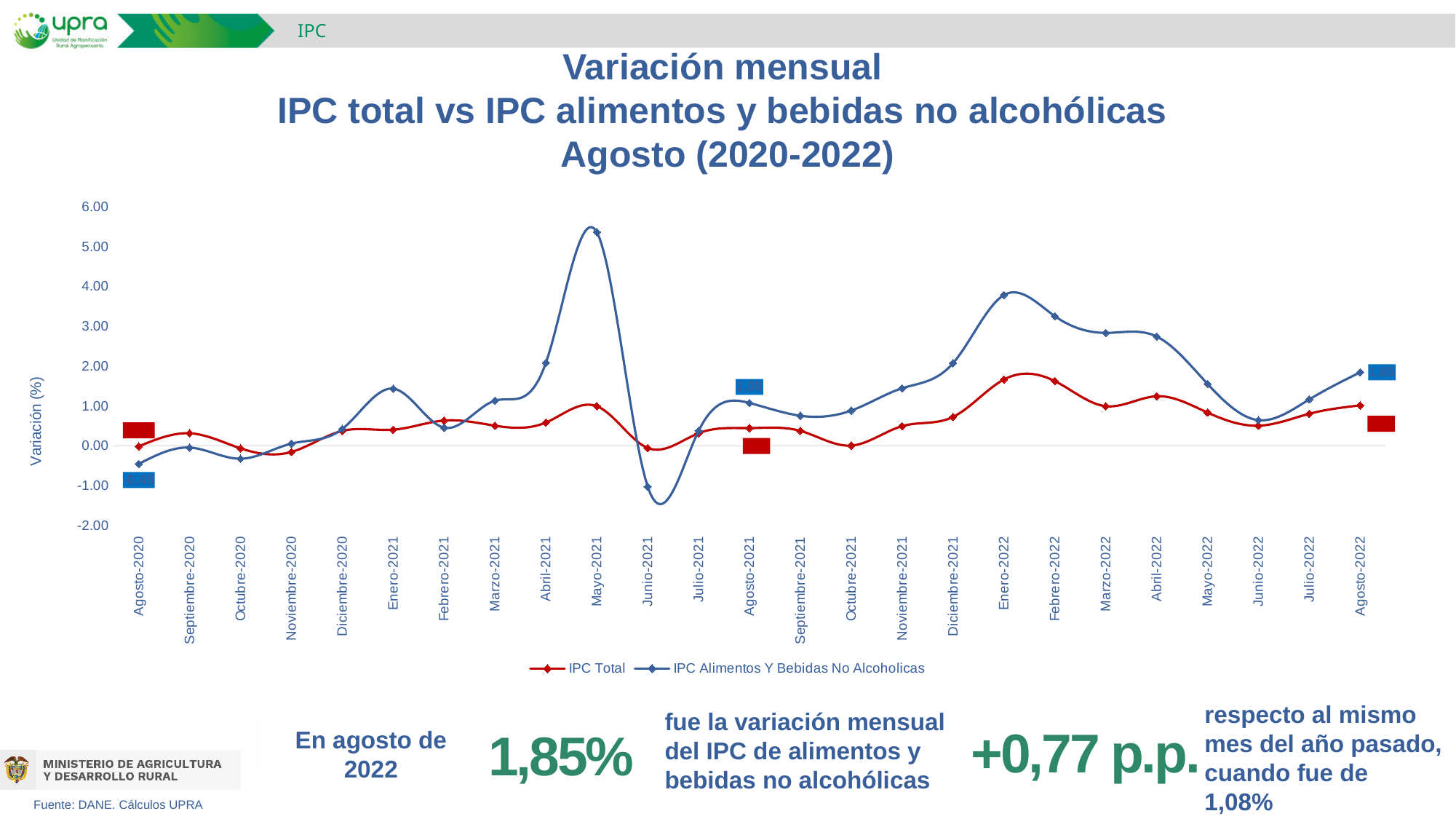
How many series does the legend list? 2 What are the two series named in the legend? IPC Total and IPC Alimentos Y Bebidas No Alcoholicas What was the monthly variation of IPC Alimentos Y Bebidas No Alcoholicas in Agosto-2021? 1,08% In which month does the IPC Alimentos Y Bebidas No Alcoholicas series reach its highest value? Mayo-2021 What was the monthly variation of IPC Alimentos Y Bebidas No Alcoholicas in Agosto-2022? 1,85% Is the value of IPC Alimentos Y Bebidas No Alcoholicas in Mayo-2021 greater or less than 5.00? greater Does the IPC Alimentos Y Bebidas No Alcoholicas series rise or fall from Enero-2022 to Junio-2022? fall In Mayo-2021, which series has the larger value, IPC Total or IPC Alimentos Y Bebidas No Alcoholicas? IPC Alimentos Y Bebidas No Alcoholicas In which month does the IPC Alimentos Y Bebidas No Alcoholicas series reach its lowest value? Junio-2021 What kind of chart is shown on the slide? line chart By how many percentage points did the IPC Alimentos Y Bebidas No Alcoholicas variation in Agosto-2022 exceed that of Agosto-2021? +0,77 p.p. How many months are plotted along the x axis? 25